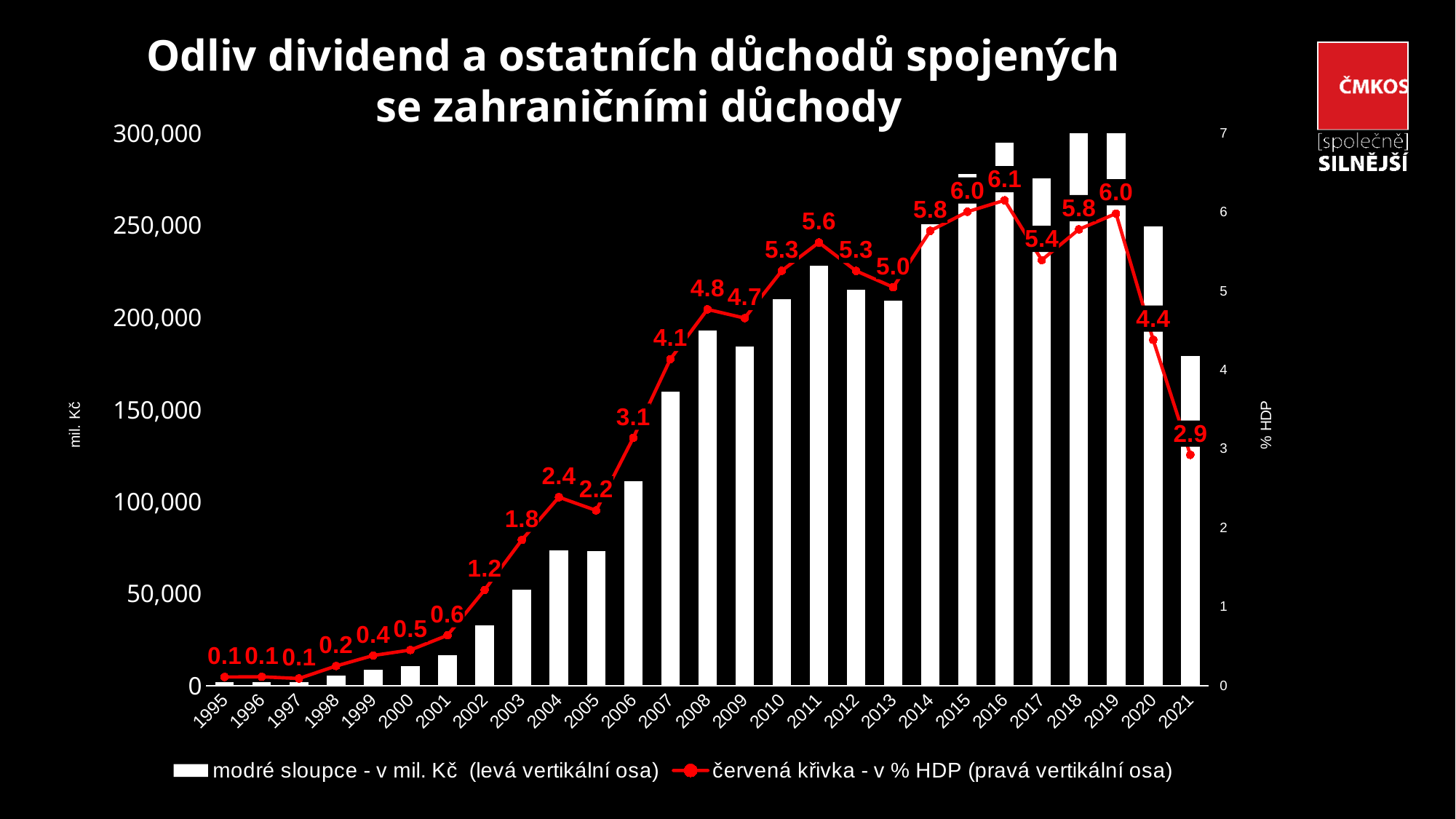
What is the value of the red line (% HDP) for 2021? 2.9 What kind of chart is shown on the slide? Combination bar and line chart Does the red line (% HDP) rise or fall from 2019 to 2021? fall What is the value of the red line (% HDP) for 2016? 6.1 Is the bar value (mil. Kč) for 2006 greater or less than 100,000? greater Is the bar value (mil. Kč) for 2021 greater or less than 150,000? greater Which year has the larger red line value, 2011 or 2013? 2011 How many series does the legend list? 2 What is the difference between the red line values for 2019 and 2021? 3.1 In which year does the red line (% HDP) reach its highest value? 2016 How many years are shown on the x axis? 27 What is the value of the red line (% HDP) for 2007? 4.1